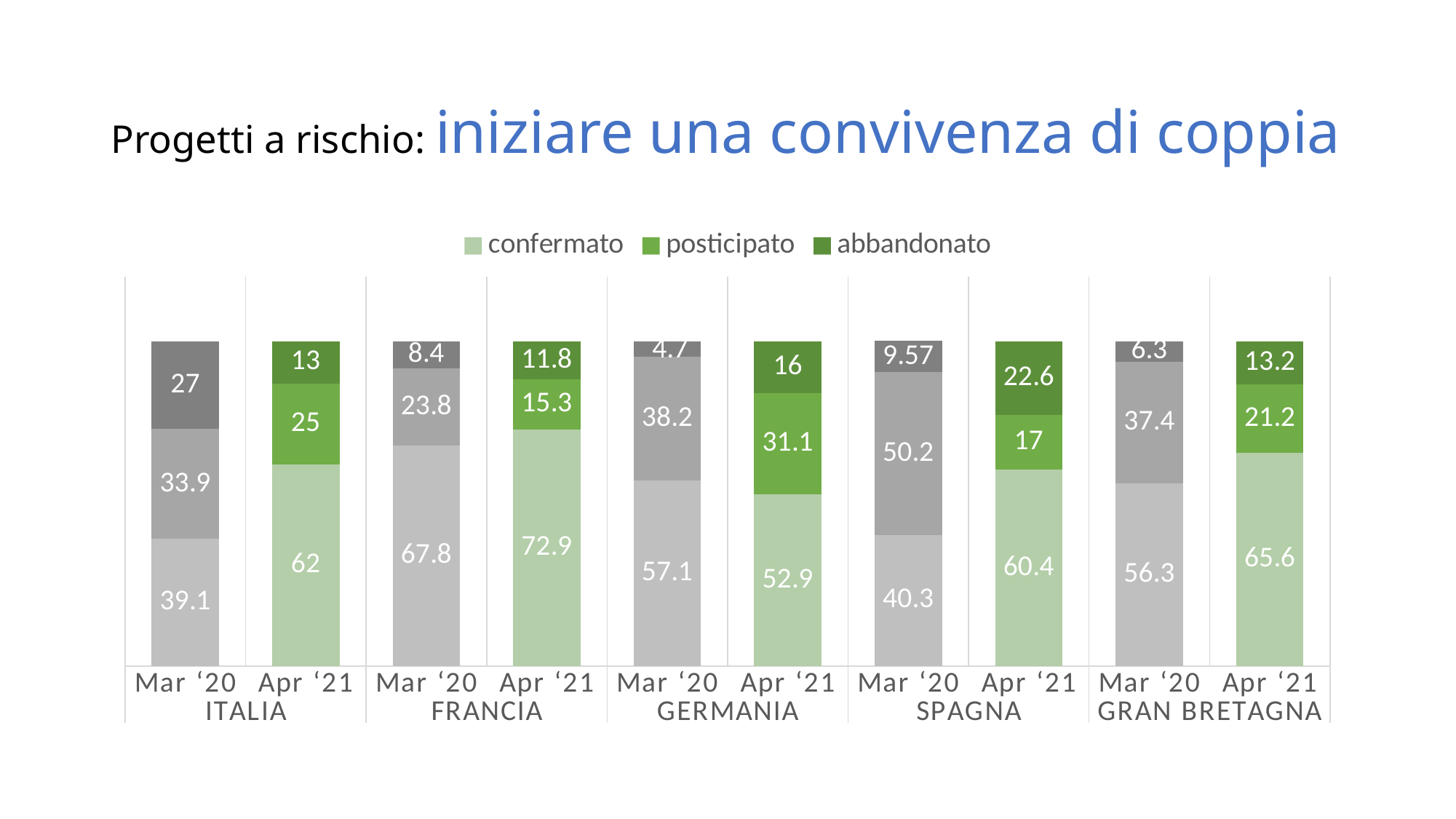
Which is larger: the 'abbandonato' value for Germania in Apr '21 or for Gran Bretagna in Apr '21? Germania Apr '21 Which country has the highest 'confermato' value in Apr '21? Francia What is the 'abbandonato' value for Spagna in Apr '21? 22.6 How many series does the legend list? 3 What is the difference between the 'confermato' values for Italia in Apr '21 and Mar '20? 22.9 What kind of chart is shown on the slide? stacked bar chart How many bars are plotted in the chart? 10 Which legend entry is shown in the darkest green? abbandonato What is the 'posticipato' value for Germania in Mar '20? 38.2 Which country has the lowest 'confermato' value in Mar '20? Italia What is the total of the stacked bar for Italia in Apr '21? 100 What is the 'confermato' value for Italia in Apr '21? 62